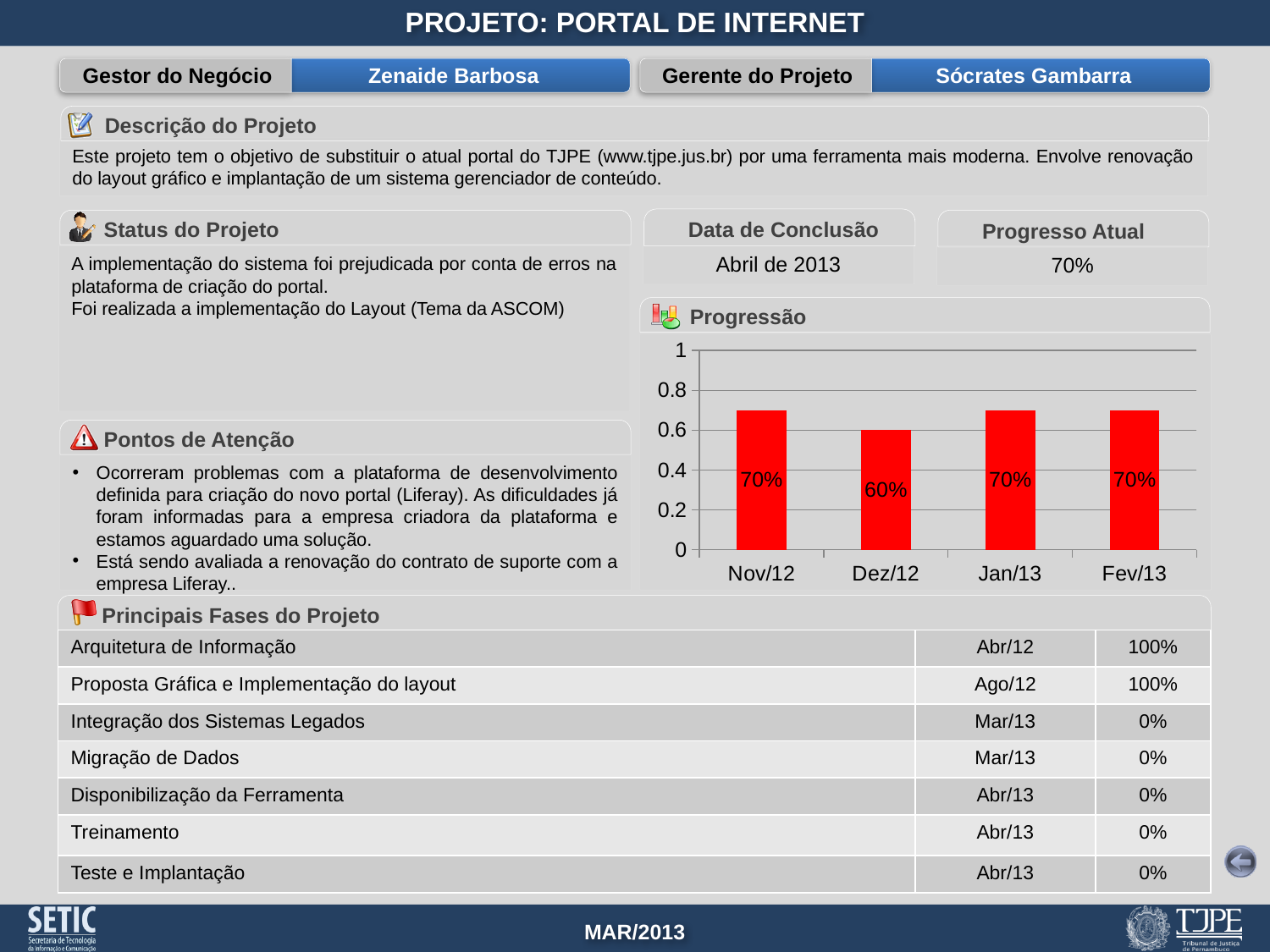
Is the value for Dez/12 in the Progressão chart greater or less than 0.8? less Which category has the lowest value in the Progressão chart? Dez/12 What is the difference between the values for Nov/12 and Dez/12 in the Progressão chart? 10% What is the value for Nov/12 in the Progressão chart? 70% Is the value for Jan/13 in the Progressão chart greater or less than 0.6? greater How many categories are shown on the x axis of the Progressão chart? 4 What kind of chart is the Progressão chart? bar chart Which is larger in the Progressão chart, the value for Dez/12 or the value for Jan/13? Jan/13 What is the value for Dez/12 in the Progressão chart? 60% What is the value for Fev/13 in the Progressão chart? 70% What colour are the bars in the Progressão chart? red What is the title of the chart on the slide? Progressão